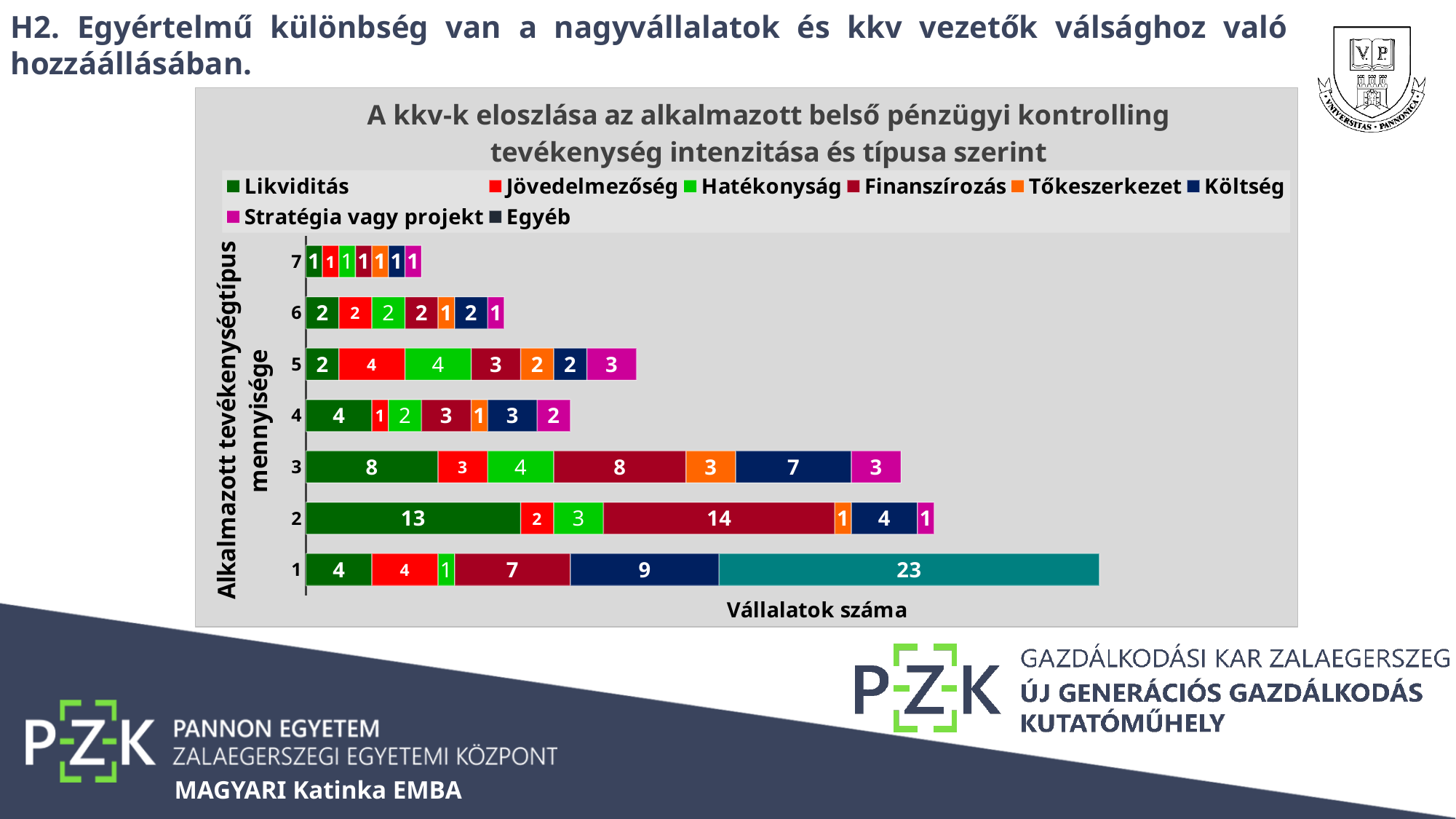
Which category has the longest stacked bar overall? 1 What is the total of the stacked bar for category 1? 48 What kind of chart is shown on the slide? Stacked bar chart What is the value of the Jövedelmezőség segment for category 5? 4 What is the title of the horizontal axis? Vállalatok száma What is the value of the Költség segment for category 3? 7 What is the total of the stacked bar for category 7? 7 What is the difference between the Likviditás value for category 2 and the Likviditás value for category 3? 5 What is the value of the Finanszírozás segment for category 2? 14 How many categories are shown on the vertical axis? 7 How many series does the legend list? 8 What is the value of the Egyéb segment for category 1? 23